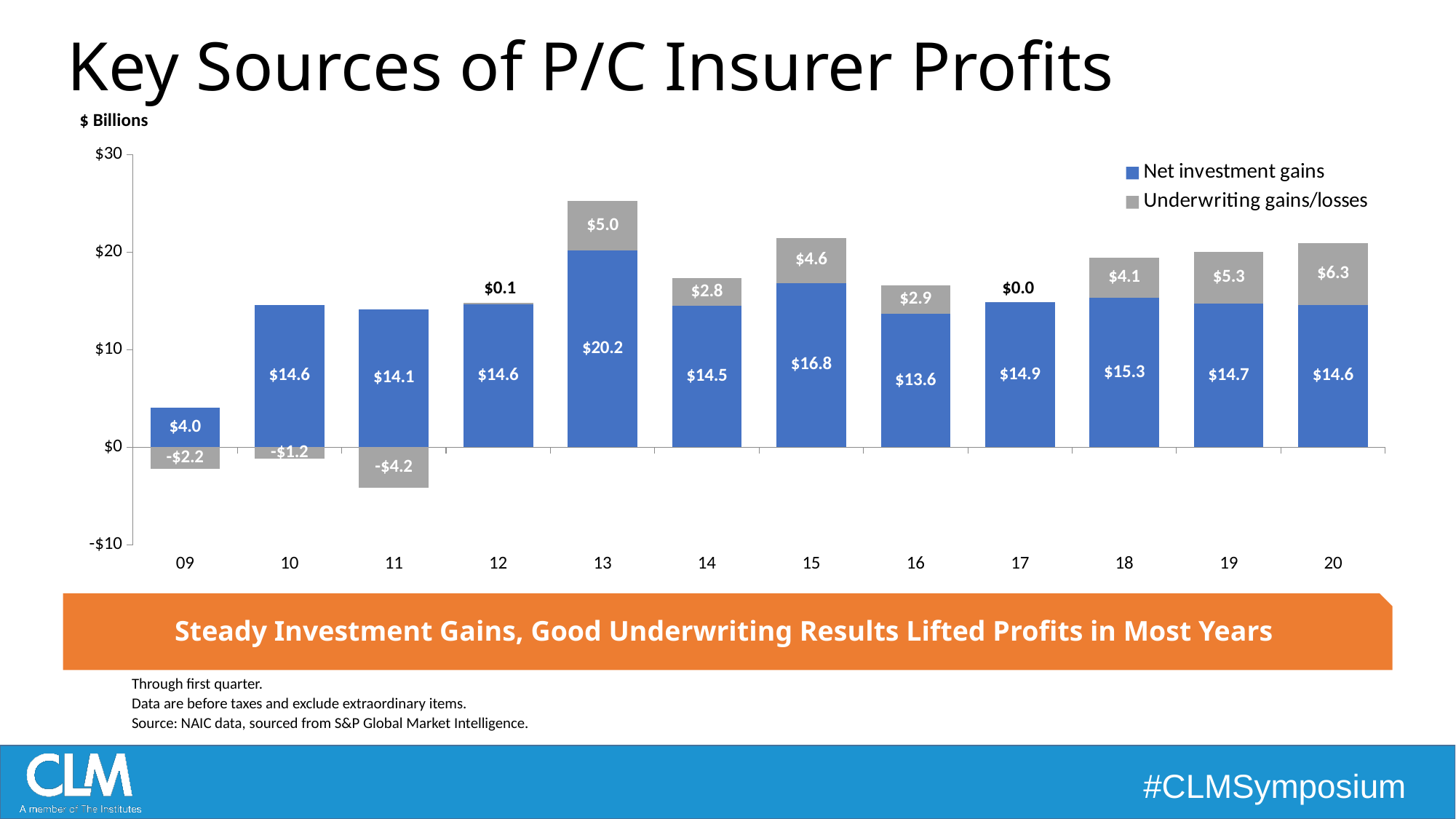
How many years are shown on the x axis? 12 How many series does the legend list? 2 What is the total of the stacked bar for 20 (Net investment gains plus Underwriting gains/losses)? $20.9 What is the value of Underwriting gains/losses for 11? -$4.2 What kind of chart is shown on the slide? Stacked bar chart Which year has the lowest Underwriting gains/losses value? 11 Which year has the highest Underwriting gains/losses value? 20 Which year has the highest Net investment gains? 13 Which year has the lowest Net investment gains? 09 What is the difference between Net investment gains in 13 and in 16? $6.6 What is the value of Net investment gains for 13? $20.2 Which year has the larger Underwriting gains/losses value, 18 or 19? 19